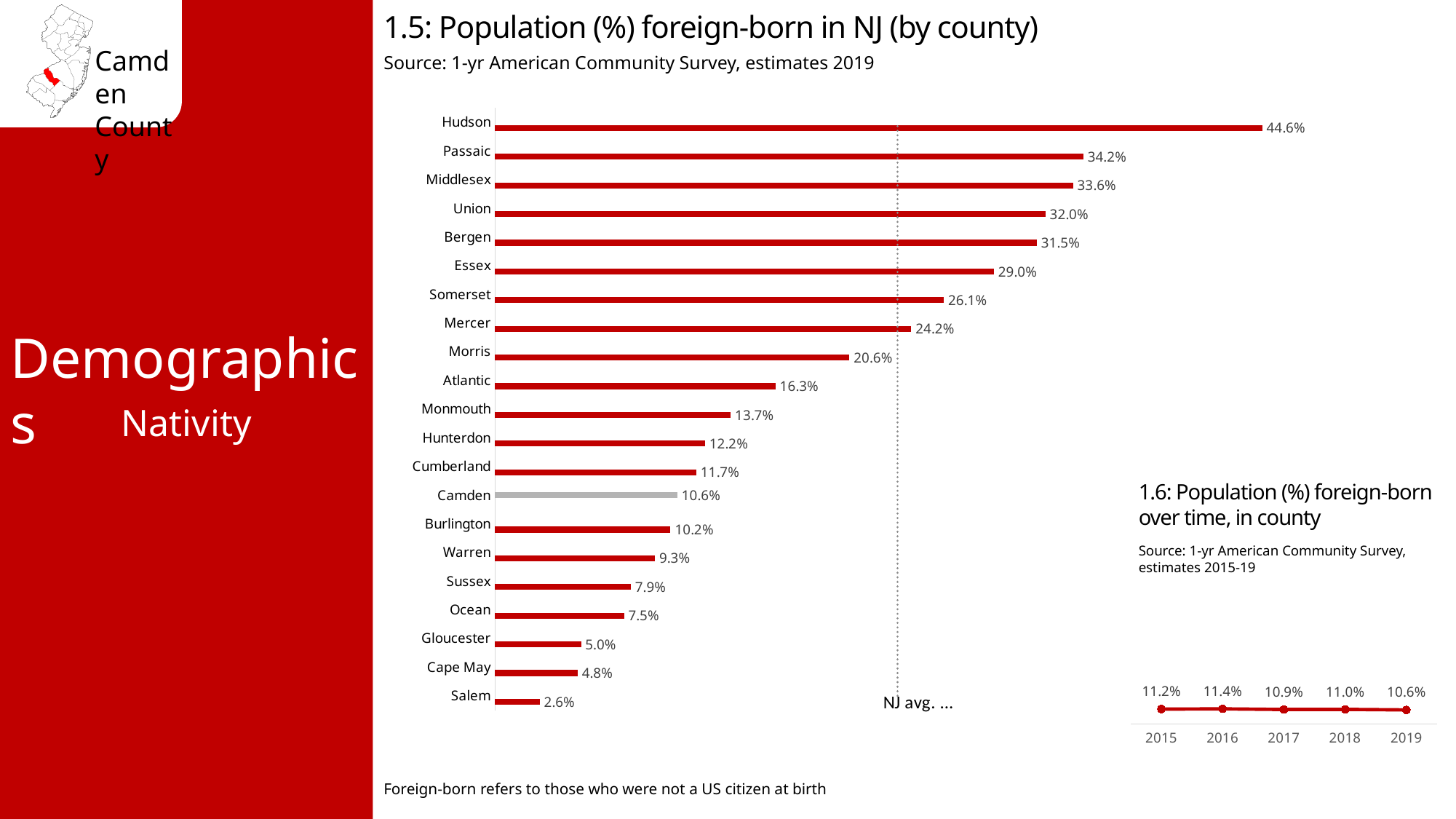
What kind of chart is chart 1.5 (Population (%) foreign-born in NJ by county)? Bar chart In chart 1.6 (Population (%) foreign-born over time, in county), what is the value for 2016? 11.4% In chart 1.5 (Population (%) foreign-born in NJ by county), which county has the lowest value? Salem What kind of chart is chart 1.6 (Population (%) foreign-born over time, in county)? Line chart In chart 1.5 (Population (%) foreign-born in NJ by county), how many counties are shown? 21 In chart 1.5 (Population (%) foreign-born in NJ by county), what is the value for Camden? 10.6% In chart 1.5 (Population (%) foreign-born in NJ by county), what is the value for Hudson? 44.6% In chart 1.5 (Population (%) foreign-born in NJ by county), which county has the highest value? Hudson In chart 1.5 (Population (%) foreign-born in NJ by county), which is larger, Mercer or Morris? Mercer In chart 1.5 (Population (%) foreign-born in NJ by county), what is the difference between Passaic and Middlesex? 0.6% In chart 1.6 (Population (%) foreign-born over time, in county), what is the difference between 2015 and 2019? 0.6% In chart 1.6 (Population (%) foreign-born over time, in county), which year has the lowest value? 2019